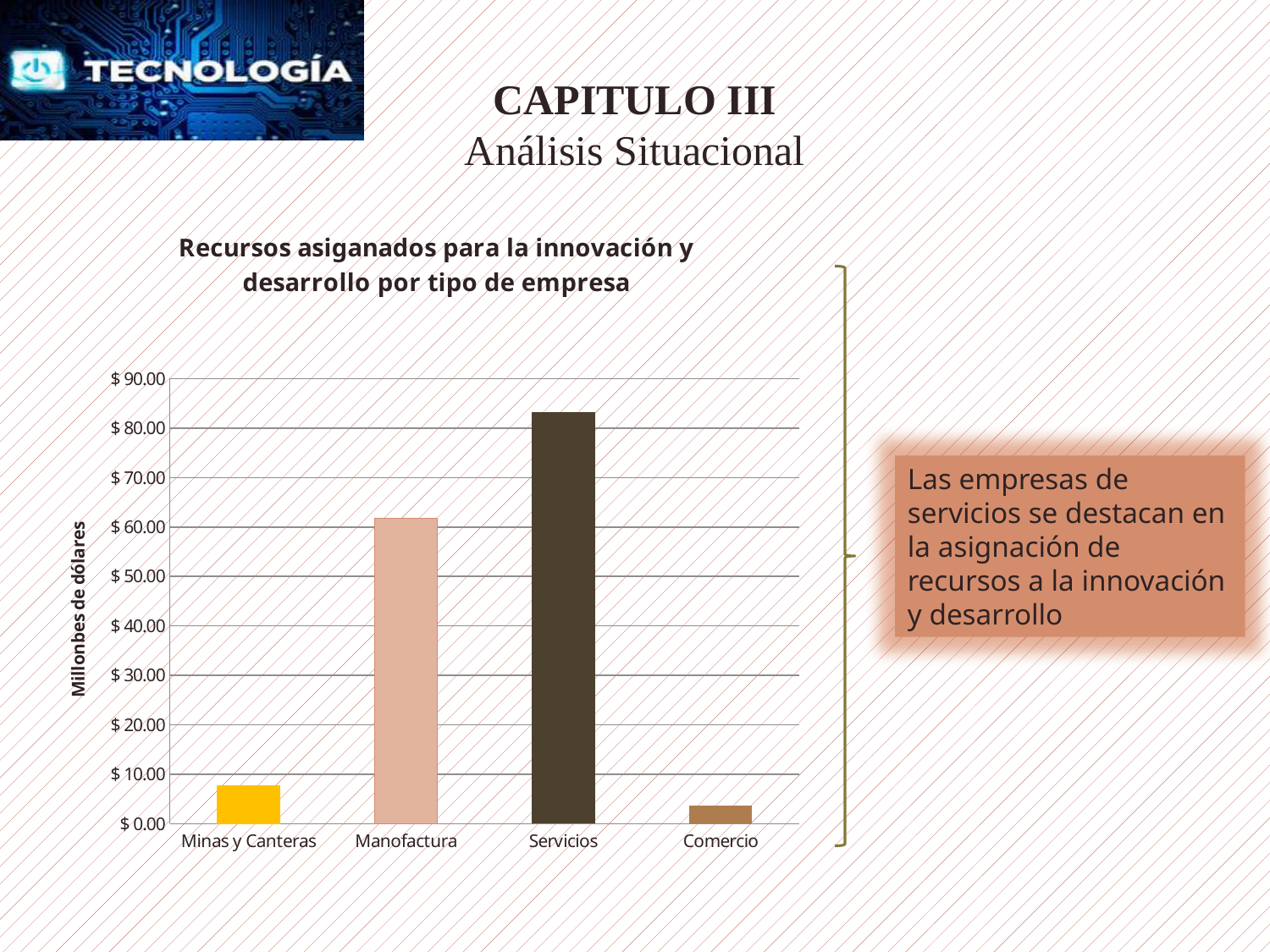
Is the value for Manofactura greater or less than $ 70.00? less Is the value for Minas y Canteras greater or less than $ 10.00? less What is the label of the vertical axis of the chart? Millonbes de dólares Which is larger, the value for Manofactura or the value for Minas y Canteras? Manofactura Which type of company has the highest value in the chart? Servicios How many categories (types of company) are shown on the x axis of the chart? 4 What is the title of the chart? Recursos asiganados para la innovación y desarrollo por tipo de empresa Is the value for Servicios greater or less than $ 80.00? greater What kind of chart is shown on the slide? Bar chart Which type of company has the lowest value in the chart? Comercio Which is larger, the value for Servicios or the value for Manofactura? Servicios